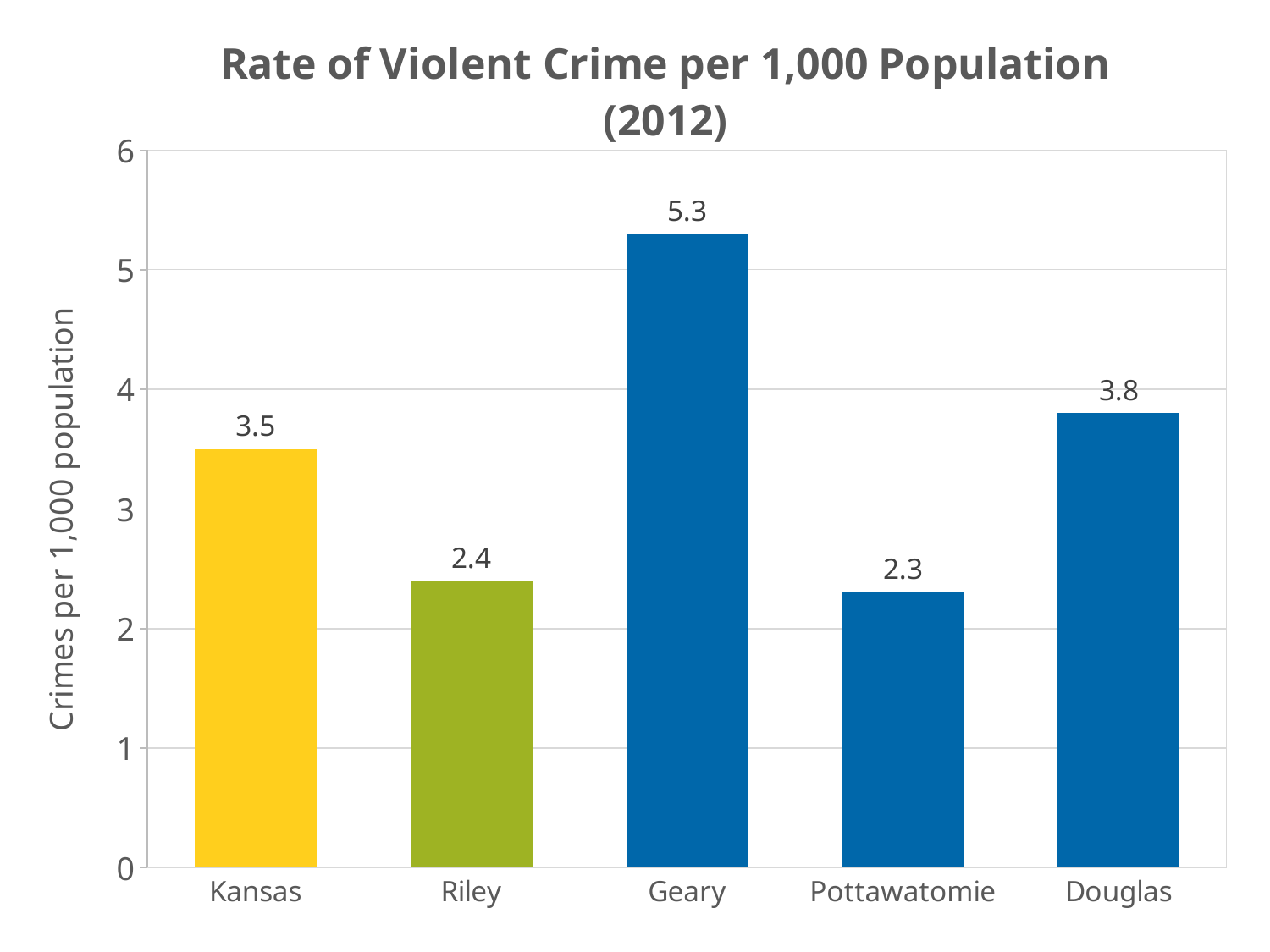
Which category has the highest rate of violent crime? Geary What is the difference between the values for Geary and Riley? 2.9 How many categories are shown on the x axis? 5 What is the value shown for Geary? 5.3 Which category has the lowest rate of violent crime? Pottawatomie What is the value shown for Pottawatomie? 2.3 Is the value for Riley greater or less than 3? less What is the rate of violent crime per 1,000 population for Kansas? 3.5 What is the title of the chart? Rate of Violent Crime per 1,000 Population (2012) What is the value shown for Douglas? 3.8 Which has a higher value, Kansas or Douglas? Douglas What kind of chart is shown on the slide? Bar chart